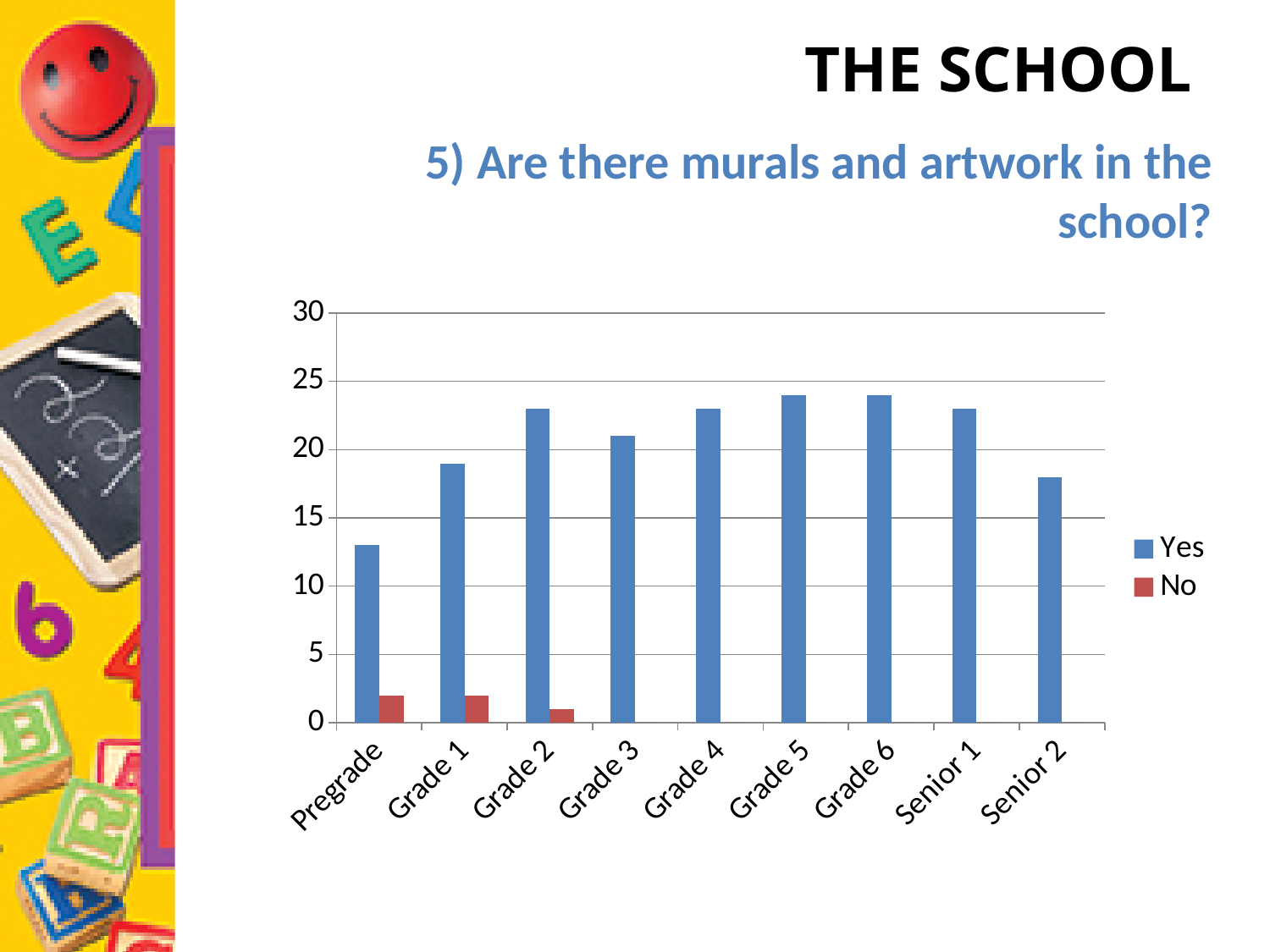
Which is larger, the Yes value for Pregrade or the Yes value for Grade 1? Grade 1 What survey question does the chart on the slide relate to? Are there murals and artwork in the school? How many series does the legend list? 2 How many grade categories are shown on the x axis? 9 Is the Yes value for Grade 5 greater or less than 20? greater Is the No value for Pregrade greater or less than 5? less Is the Yes value for Senior 2 greater or less than 15? greater Which is larger, the Yes value for Senior 1 or the Yes value for Senior 2? Senior 1 What kind of chart is shown on the slide? bar chart What are the two entries in the chart legend? Yes and No Which category has the lowest Yes value? Pregrade